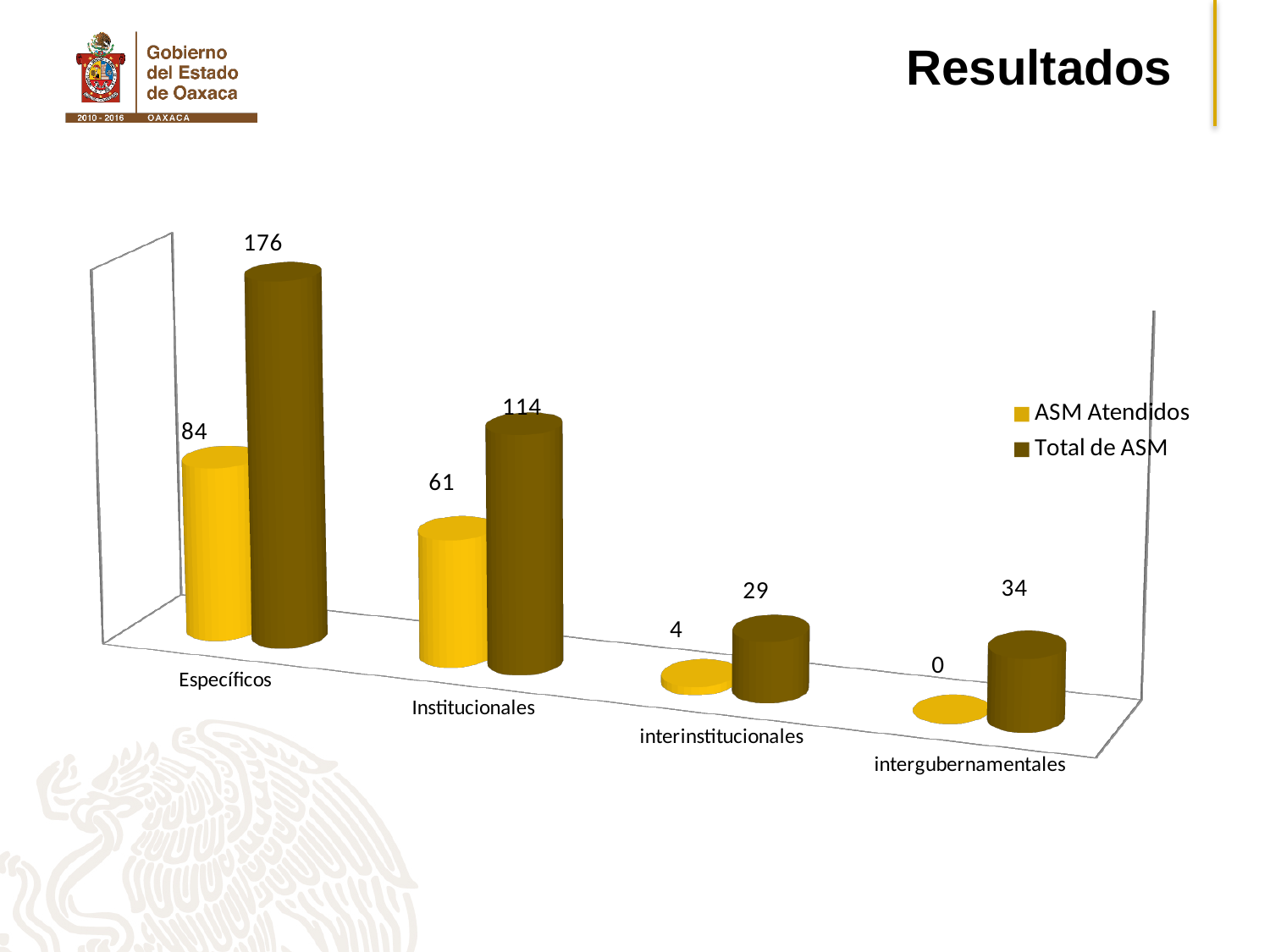
How many categories are shown on the x axis? 4 What is the value of Total de ASM for Institucionales? 114 What is the value of ASM Atendidos for intergubernamentales? 0 Which is larger: Total de ASM for interinstitucionales or Total de ASM for intergubernamentales? intergubernamentales What is the value of Total de ASM for interinstitucionales? 29 Which category has the highest Total de ASM? Específicos What kind of chart is shown on the slide? bar chart What is the difference between Total de ASM and ASM Atendidos for Específicos? 92 What is the value of ASM Atendidos for Específicos? 84 What is the difference between Total de ASM and ASM Atendidos for Institucionales? 53 Which category has the lowest ASM Atendidos? intergubernamentales How many series does the legend list? 2